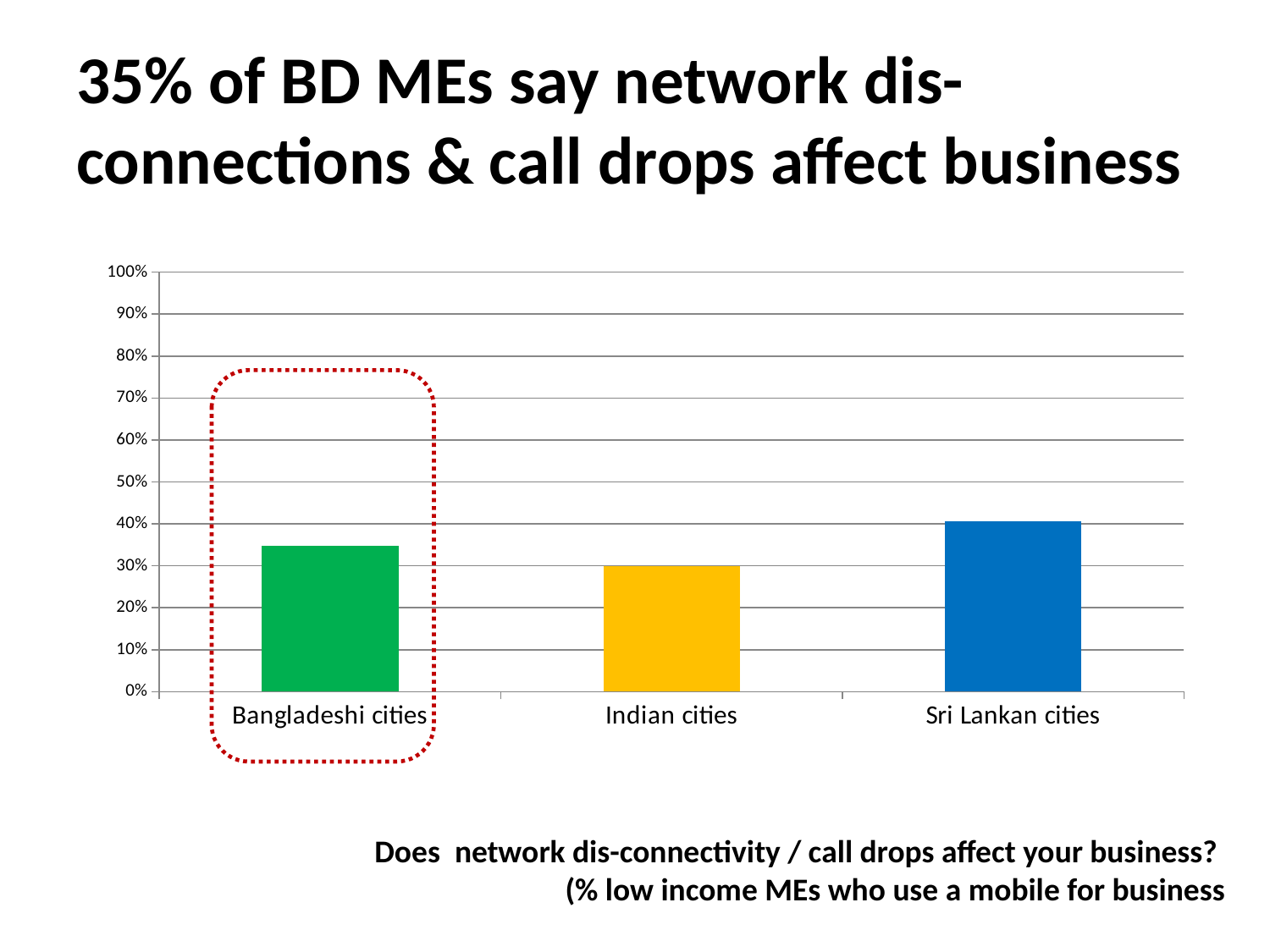
Which category has the lowest bar in the chart? Indian cities Which is larger, the value for Bangladeshi cities or the value for Indian cities? Bangladeshi cities What colour is the bar for Indian cities? yellow Is the value for Sri Lankan cities greater or less than 30%? greater Which category's bar is highlighted with a red dotted outline? Bangladeshi cities Is the value for Indian cities greater or less than 50%? less What type of chart is shown on the slide? bar chart Which is larger, the value for Sri Lankan cities or the value for Bangladeshi cities? Sri Lankan cities Is the value for Bangladeshi cities greater or less than 40%? less Which category has the highest bar in the chart? Sri Lankan cities According to the slide title, what percentage of Bangladeshi MEs say network dis-connections and call drops affect business? 35% How many categories (city groups) are shown on the x axis of the chart? 3